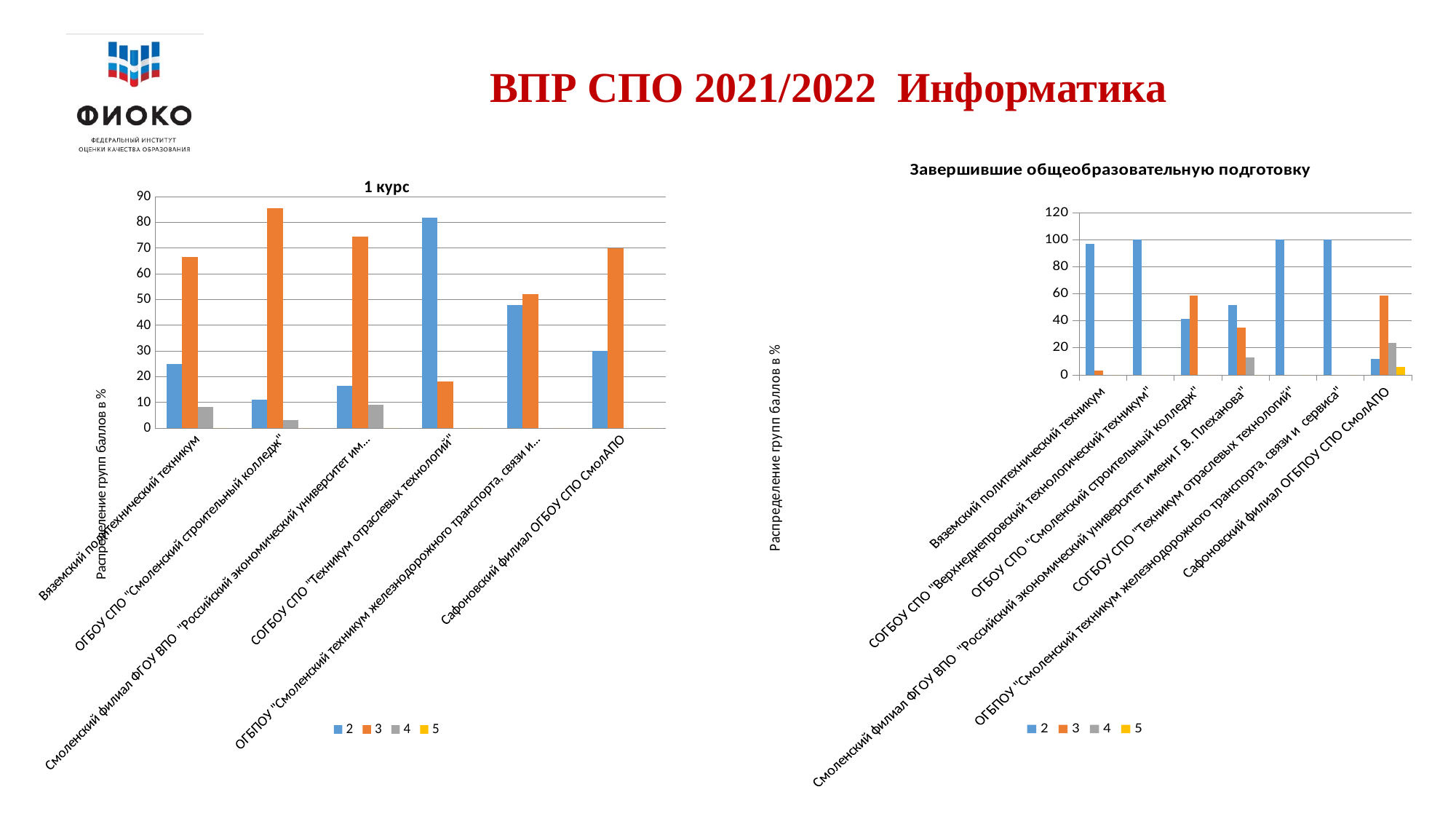
In the "Завершившие общеобразовательную подготовку" chart, which institution has the highest value for series 4? Сафоновский филиал ОГБПОУ СПО СмолАПО In the "Завершившие общеобразовательную подготовку" chart, what is the value of series 2 for СОГБОУ СПО "Верхнеднепровский технологический техникум"? 100 What is the label of the vertical axis on the "Завершившие общеобразовательную подготовку" chart? Распределение групп баллов в % What kind of chart is the "1 курс" chart? bar chart In the "1 курс" chart, for Вяземский политехнический техникум, which is larger: series 2 or series 3? series 3 How many categories (institutions) are shown on the x axis of the "Завершившие общеобразовательную подготовку" chart? 7 How many series does the legend of the "1 курс" chart list? 4 In the "1 курс" chart, is the value of series 3 for Вяземский политехнический техникум greater or less than 60? greater How many categories (institutions) are shown on the x axis of the "1 курс" chart? 6 In the "1 курс" chart, which institution has the highest value for series 2? СОГБОУ СПО "Техникум отраслевых технологий" In the "1 курс" chart, is the value of series 3 for ОГБОУ СПО "Смоленский строительный колледж" greater or less than 80? greater In the "1 курс" chart, which institution has the highest value for series 3? ОГБОУ СПО "Смоленский строительный колледж"